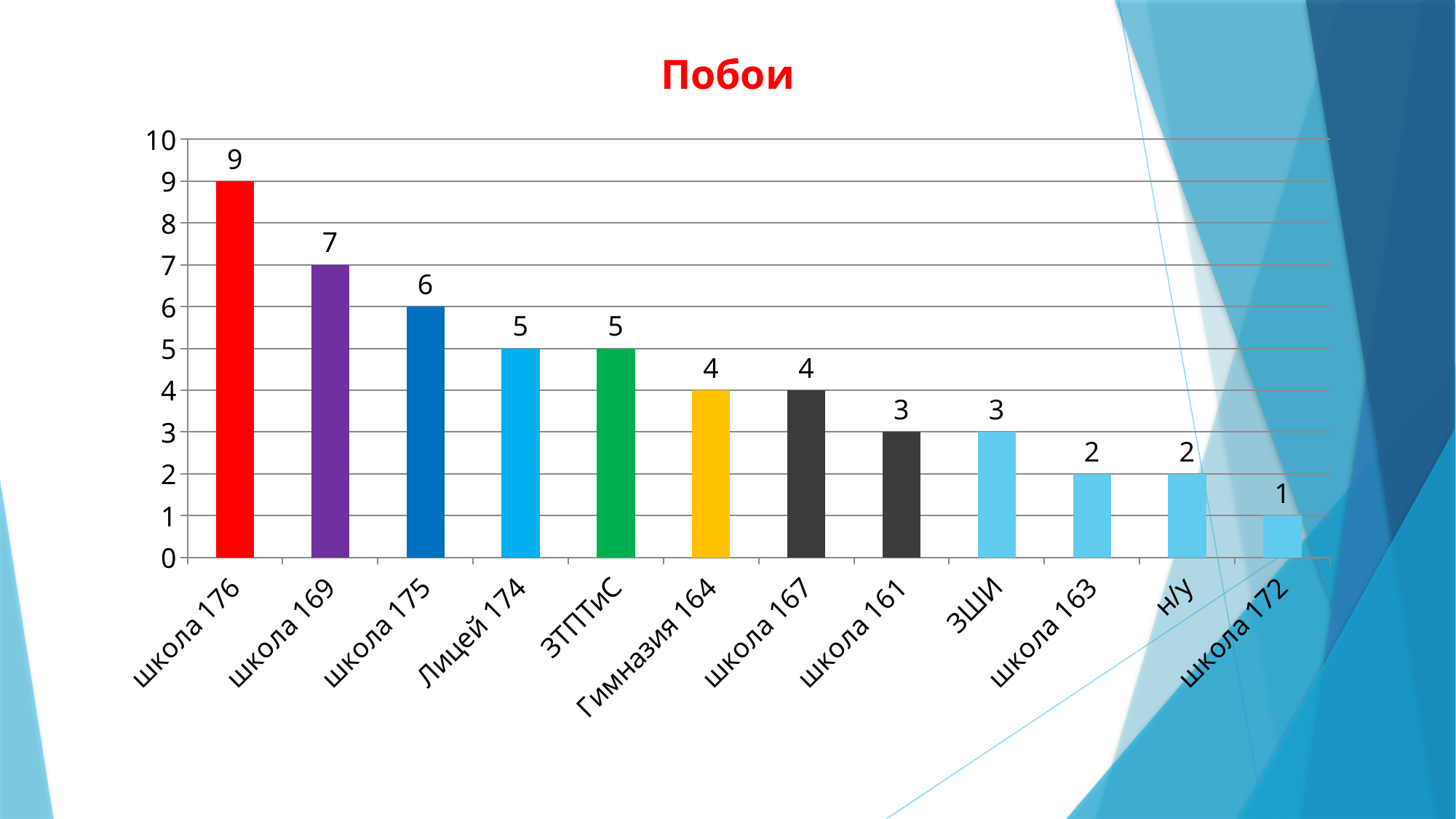
What kind of chart is this? bar chart Which is larger, the value for Лицей 174 or the value for школа 167? Лицей 174 What is the difference between the values for школа 176 and школа 169? 2 What is the title of the chart? Побои Which category has the lowest value? школа 172 Do the values rise or fall from left to right along the x axis? fall What is the value for Гимназия 164? 4 How many categories are shown on the x axis? 12 Which category has the highest value? школа 176 What is the value for школа 176? 9 What is the value for ЗШИ? 3 What is the difference between the values for школа 175 and школа 163? 4